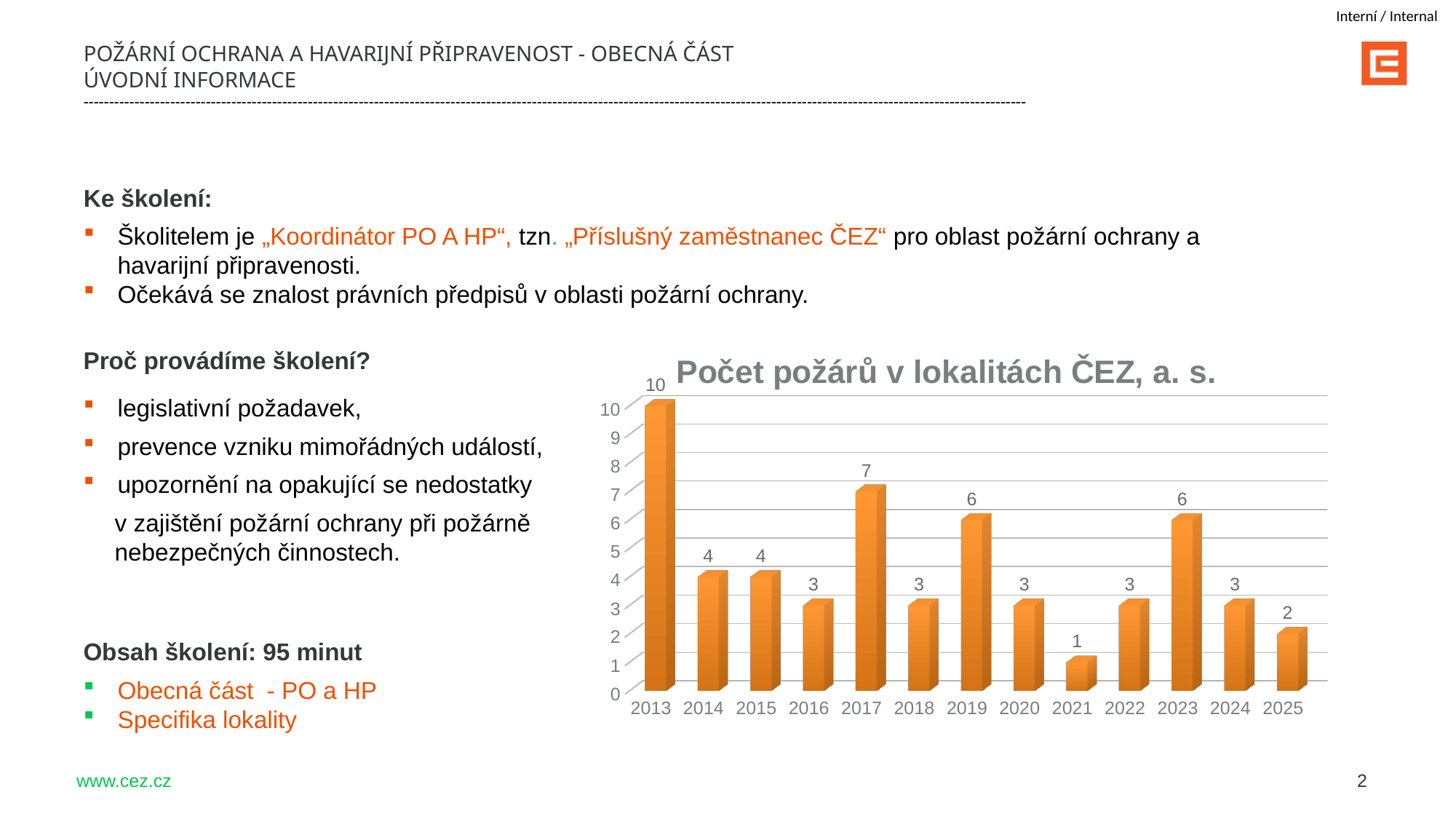
What is the difference between the values for 2013 and 2017? 3 Which year has the lowest value in the chart? 2021 What is the value for 2021 in the chart? 1 Which year has the highest value in the chart? 2013 What is the difference between the values for 2023 and 2025? 4 What is the title of the chart? Počet požárů v lokalitách ČEZ, a. s. Which is larger, the value for 2019 or the value for 2024? 2019 What is the value for 2017 in the chart? 7 What kind of chart is shown on the slide? bar chart How many years are shown on the x axis of the chart? 13 What is the value for 2013 in the chart? 10 What is the value for 2025 in the chart? 2